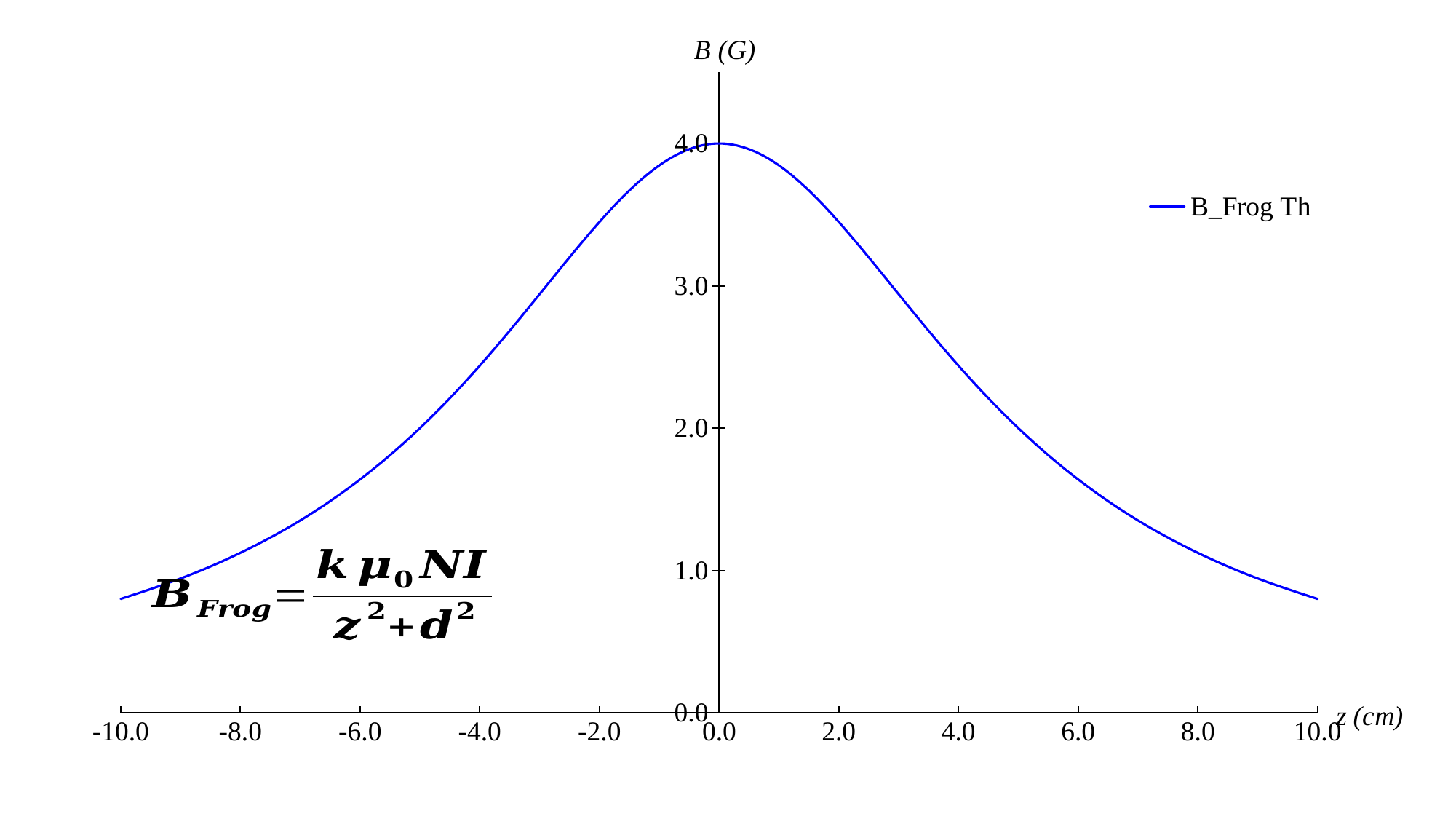
Which has the larger value of B_Frog Th: z = 2.0 cm or z = 6.0 cm? z = 2.0 cm How many series does the legend list? 1 What is the value of B_Frog Th at z = 0.0 cm? 4.0 Do the values of B_Frog Th rise or fall as z increases from 0.0 to 10.0 cm? fall Is the value of B_Frog Th at z = 2.0 cm greater or less than 3.0? greater What kind of chart is shown on the slide? line chart What is the label of the vertical axis? B (G) Is the value of B_Frog Th at z = 4.0 cm greater or less than 2.0? greater At which value of z does the B_Frog Th curve reach its highest value? 0.0 Is the value of B_Frog Th at z = -6.0 cm greater or less than 2.0? less What is the name of the series shown in the legend? B_Frog Th